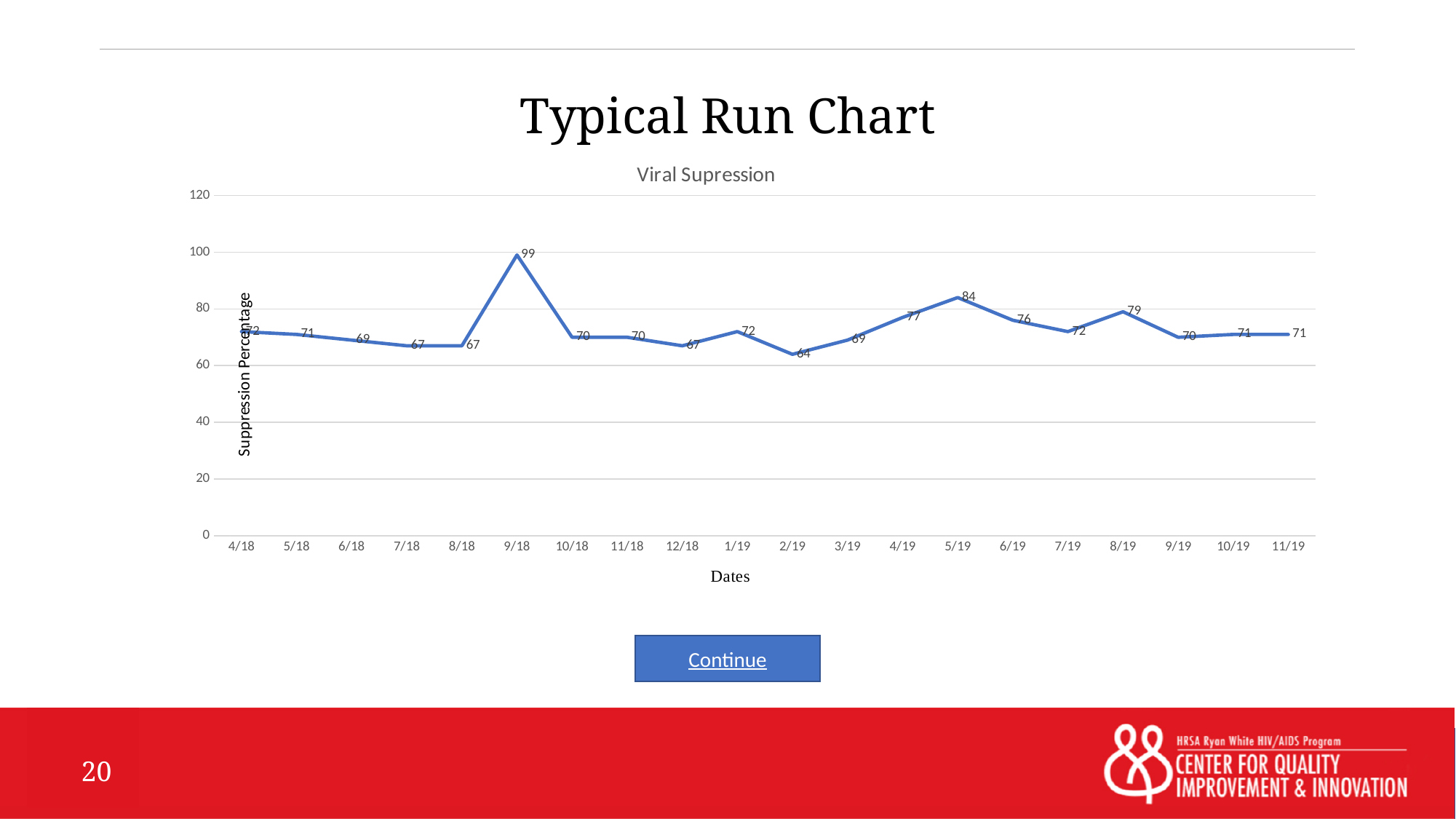
Which has a larger value, 5/19 or 8/19? 5/19 Do the values rise or fall from 2/19 to 5/19? rise What is the viral suppression value for 2/19? 64 What is the viral suppression value for 9/18? 99 What is the title of the chart? Viral Supression What kind of chart is shown on the slide? line chart Which date has the highest viral suppression value? 9/18 What is the viral suppression value for 5/19? 84 Is the value for 2/19 greater or less than 80? less What is the difference between the values for 9/18 and 10/18? 29 Which date has the lowest viral suppression value? 2/19 How many data points are plotted on the chart? 20